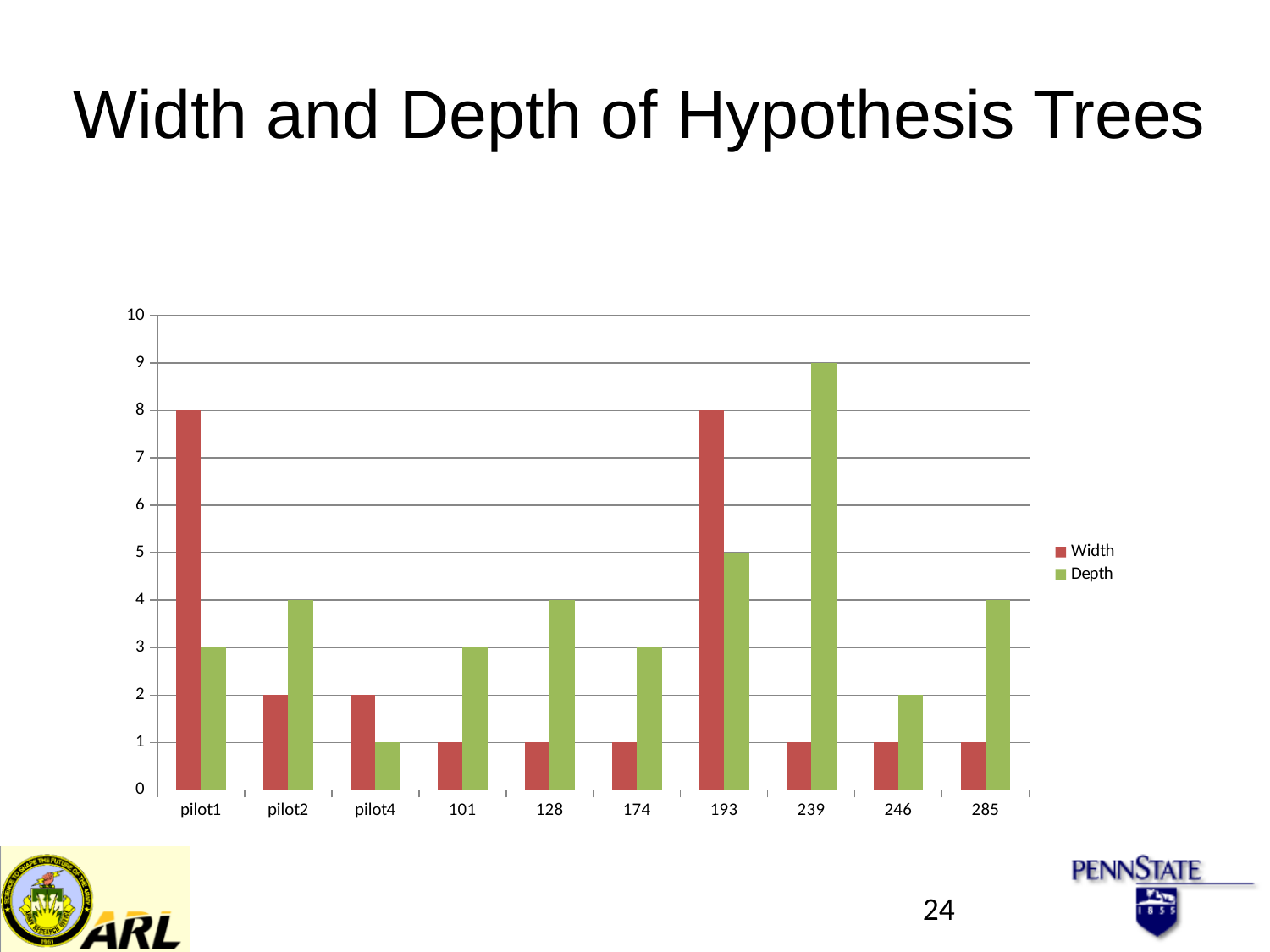
How many series does the legend list? 2 Which category has the highest Depth value? 239 Which series is shown in green in the legend? Depth What is the Depth value for 193? 5 Is the Depth value for 239 greater or less than 8? greater What is the Width value for pilot1? 8 Which is larger for pilot2, Width or Depth? Depth What is the Depth value for 239? 9 What is the difference between the Width and Depth values for 193? 3 Which category has the lowest Depth value? pilot4 How many categories are shown on the x axis? 10 What kind of chart is shown on the slide? bar chart